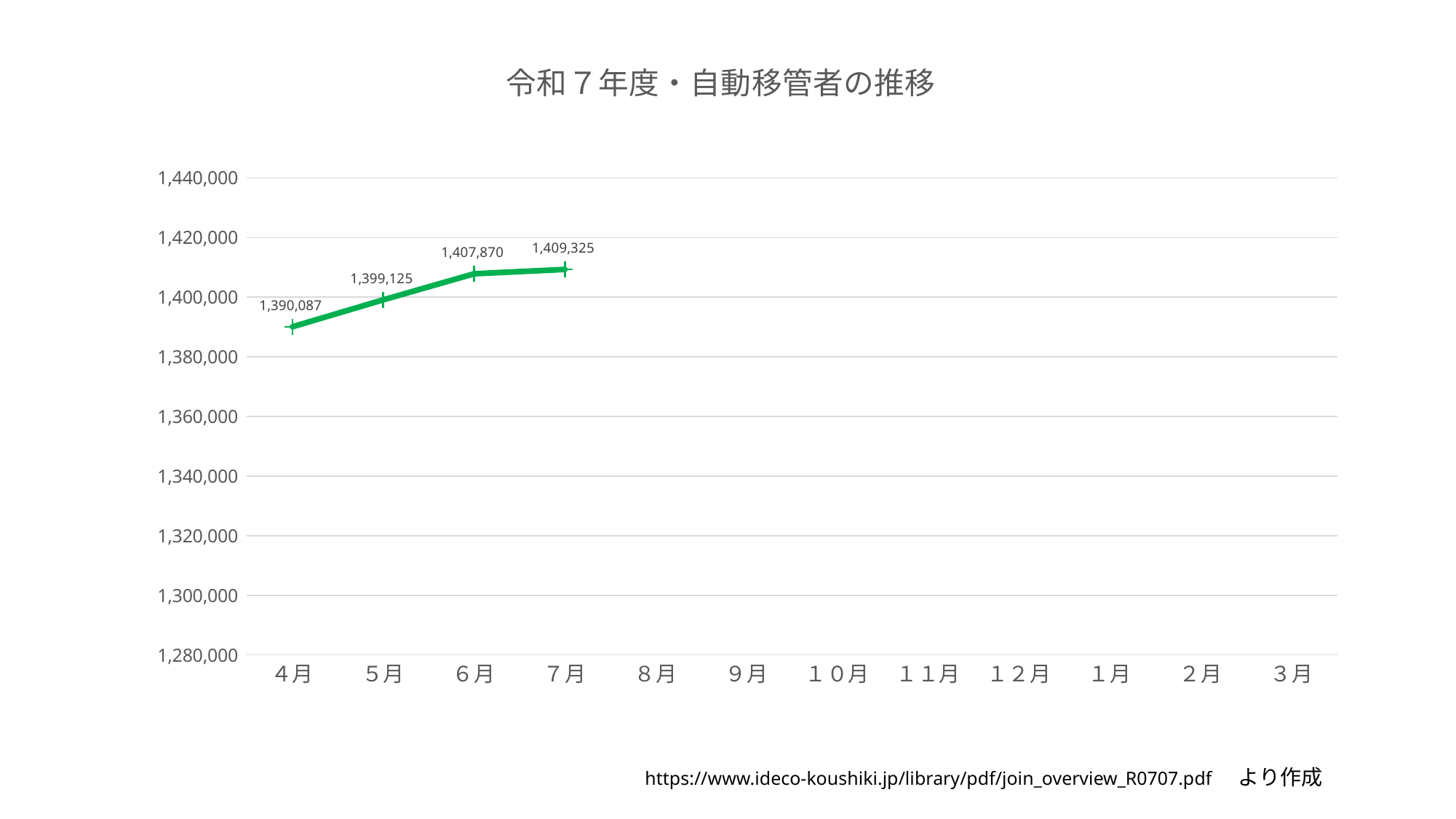
How many data points are plotted on the line? 4 What is the value for 6月? 1,407,870 Which is larger, the value for 5月 or the value for 6月? 6月 Is the value for 4月 greater or less than 1,400,000? less What is the value for 4月? 1,390,087 Which month has the highest plotted value? 7月 Which month has the lowest plotted value? 4月 What is the value for 5月? 1,399,125 What is the value for 7月? 1,409,325 What kind of chart is shown on the slide? line chart What is the difference between the values for 6月 and 5月? 8,745 What is the difference between the values for 7月 and 4月? 19,238